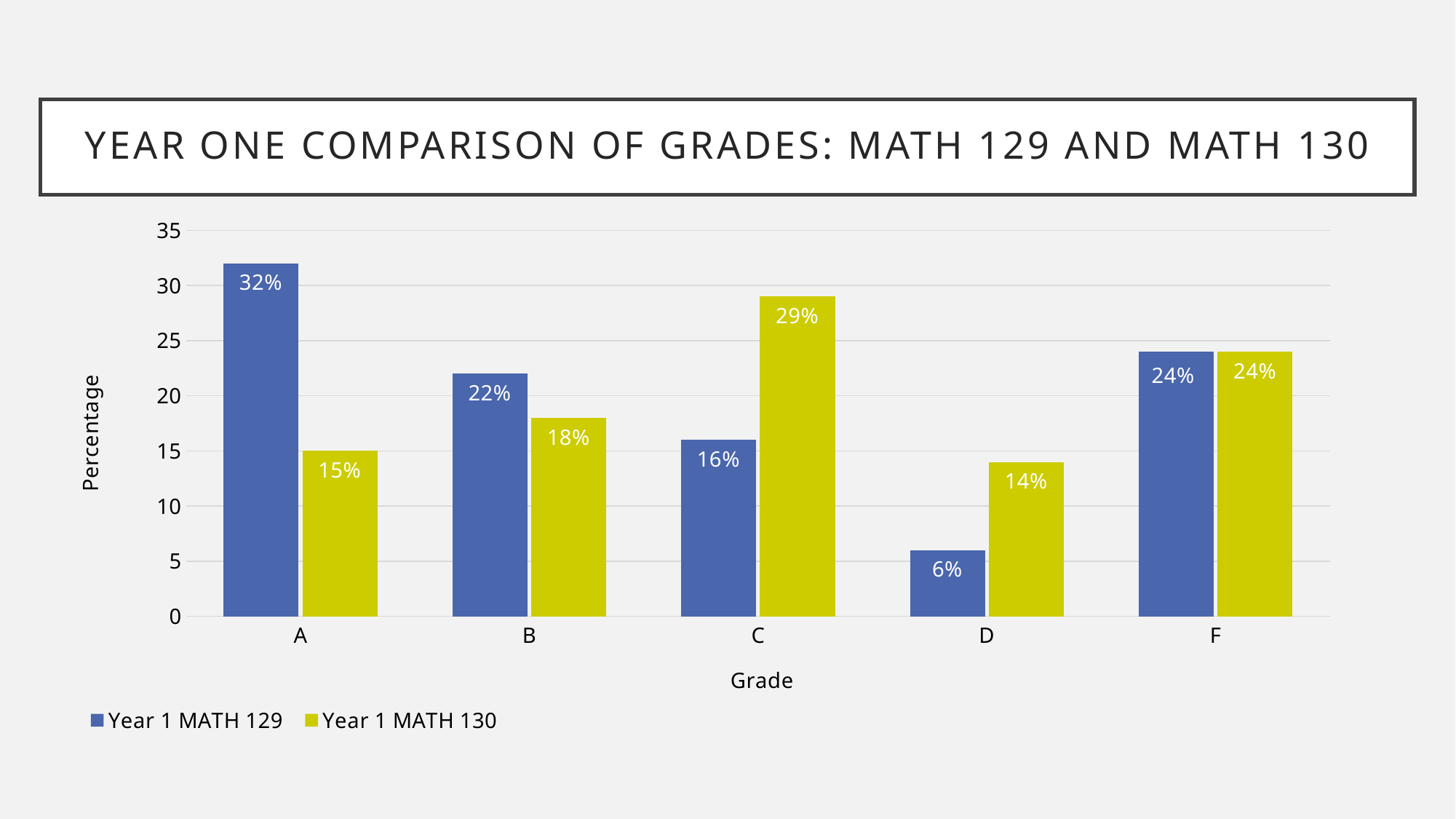
How many grade categories are shown on the x axis? 5 What percentage of Year 1 MATH 130 students received a grade of C? 29% What is the label of the y axis? Percentage Which grade has the highest percentage for Year 1 MATH 130? C What is the value for grade D in the Year 1 MATH 129 series? 6% What kind of chart is shown on the slide? Bar chart For grade B, which series has the larger value, Year 1 MATH 129 or Year 1 MATH 130? Year 1 MATH 129 How many series does the legend list? 2 Which grade has the lowest percentage for Year 1 MATH 129? D What is the value for grade F in the Year 1 MATH 130 series? 24% What percentage of Year 1 MATH 129 students received a grade of A? 32% What is the difference between the Year 1 MATH 129 and Year 1 MATH 130 percentages for grade A? 17%